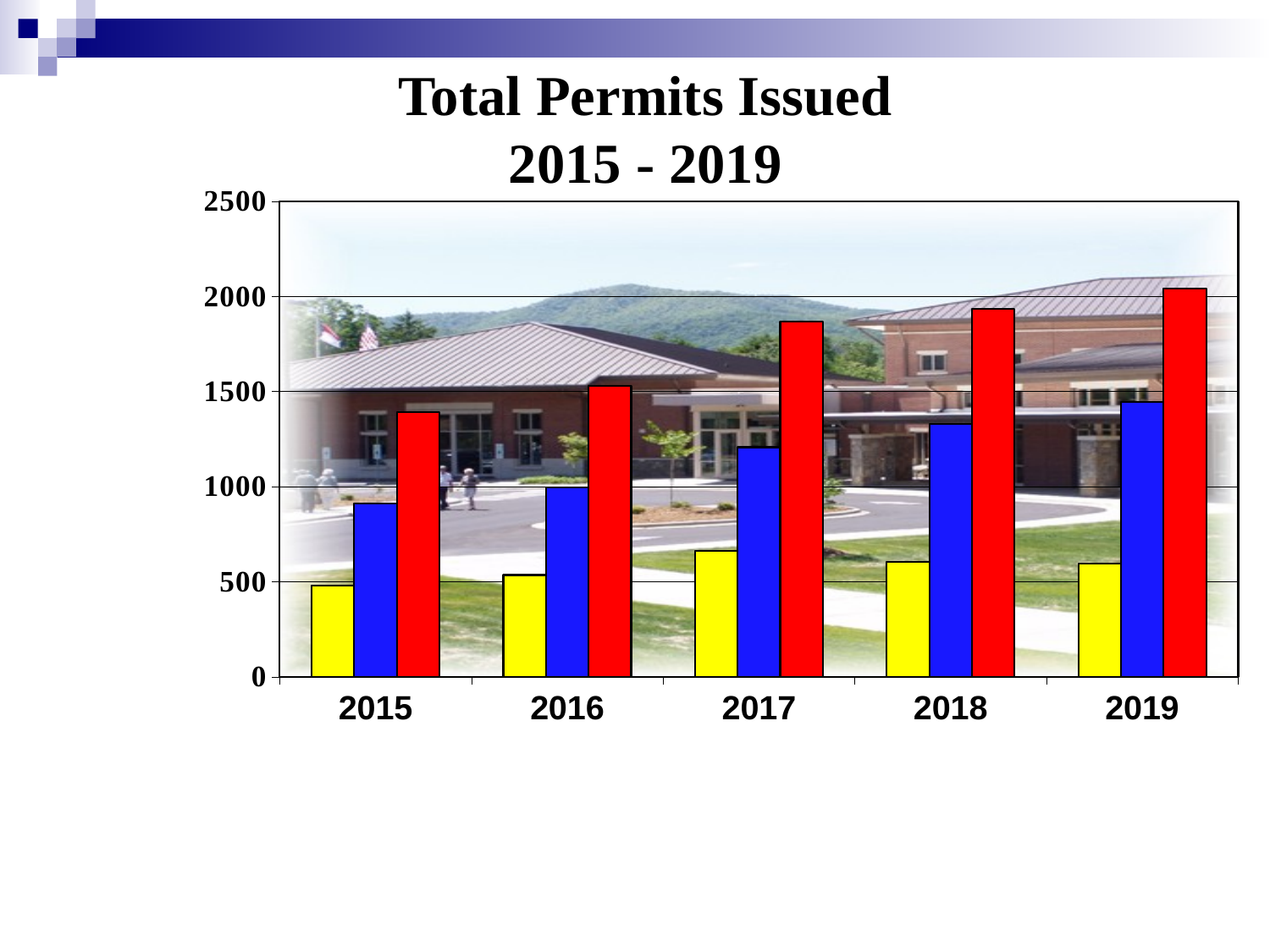
Is the value of the red bar for 2015 greater or less than 1500? less In which year is the red bar the tallest? 2019 What is the title of the chart? Total Permits Issued 2015 - 2019 Is the value of the blue bar for 2017 greater or less than 1000? greater In which year is the blue bar the shortest? 2015 Is the value of the red bar for 2019 greater or less than 2000? greater For 2018, which is larger, the red bar or the blue bar? the red bar What kind of chart is shown on the slide? bar chart How many bars are shown for each year in the chart? 3 In which year is the red bar the shortest? 2015 Do the red bars rise or fall from 2015 to 2019? rise How many years are shown on the x axis of the chart? 5